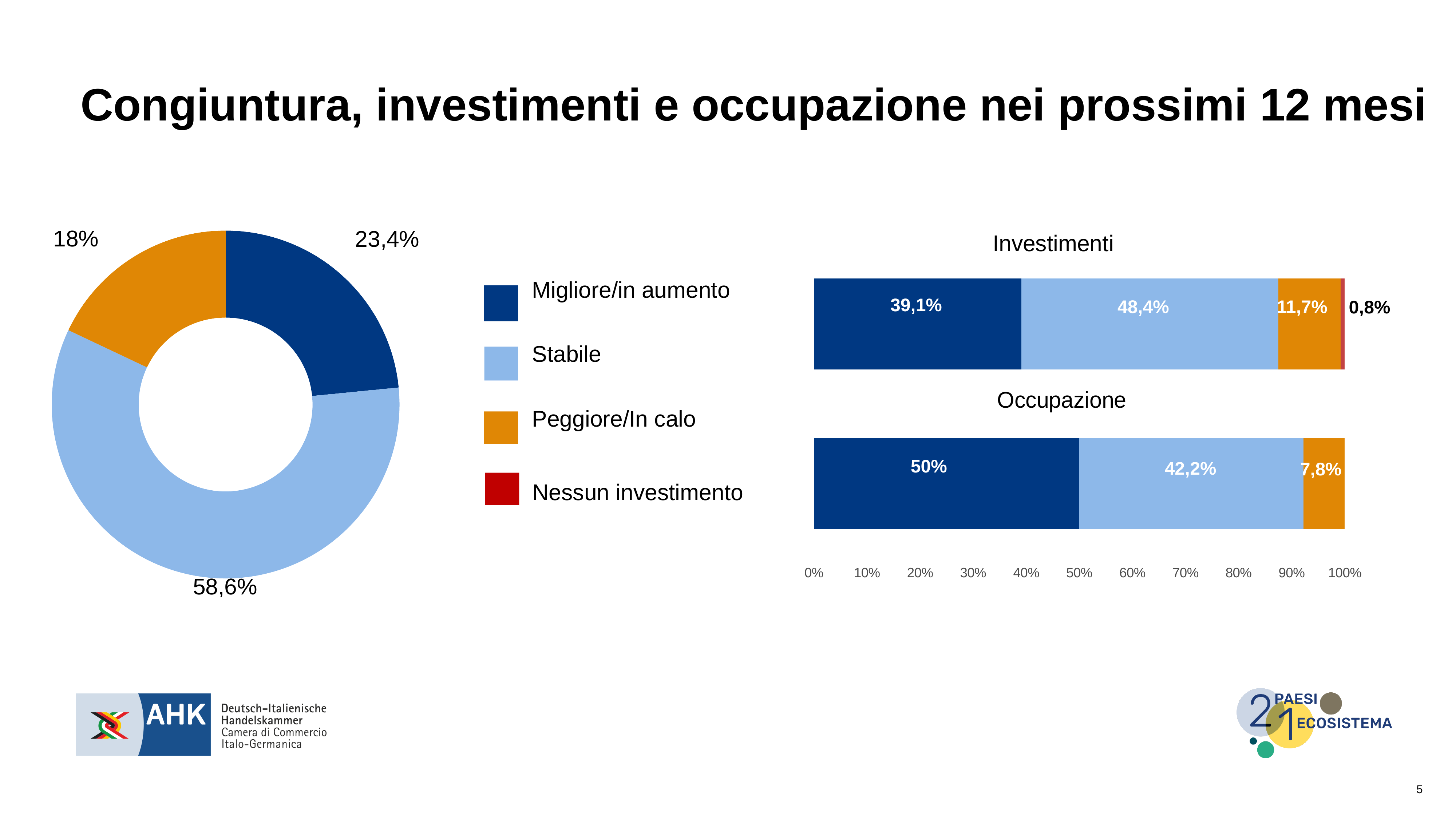
In the stacked bar chart on the right, what is the Migliore/in aumento value for Occupazione? 50% In the stacked bar chart on the right, what is the Peggiore/In calo value for Occupazione? 7,8% How many entries does the legend list? 4 In the stacked bar chart on the right, what is the Nessun investimento value for Investimenti? 0,8% What kind of chart is shown on the right side of the slide? Stacked bar chart In the stacked bar chart on the right, which bar has the larger Migliore/in aumento segment, Investimenti or Occupazione? Occupazione In the donut chart on the left, what is the value for Migliore/in aumento? 23,4% In the stacked bar chart on the right, what is the Stabile value for Investimenti? 48,4% In the stacked bar chart on the right, what is the difference between the Peggiore/In calo values for Investimenti and Occupazione? 3,9% In the donut chart on the left, what is the value for Stabile? 58,6% In the donut chart on the left, what is the difference between the Stabile and Peggiore/In calo values? 40,6% In the donut chart on the left, which category has the smallest share? Peggiore/In calo